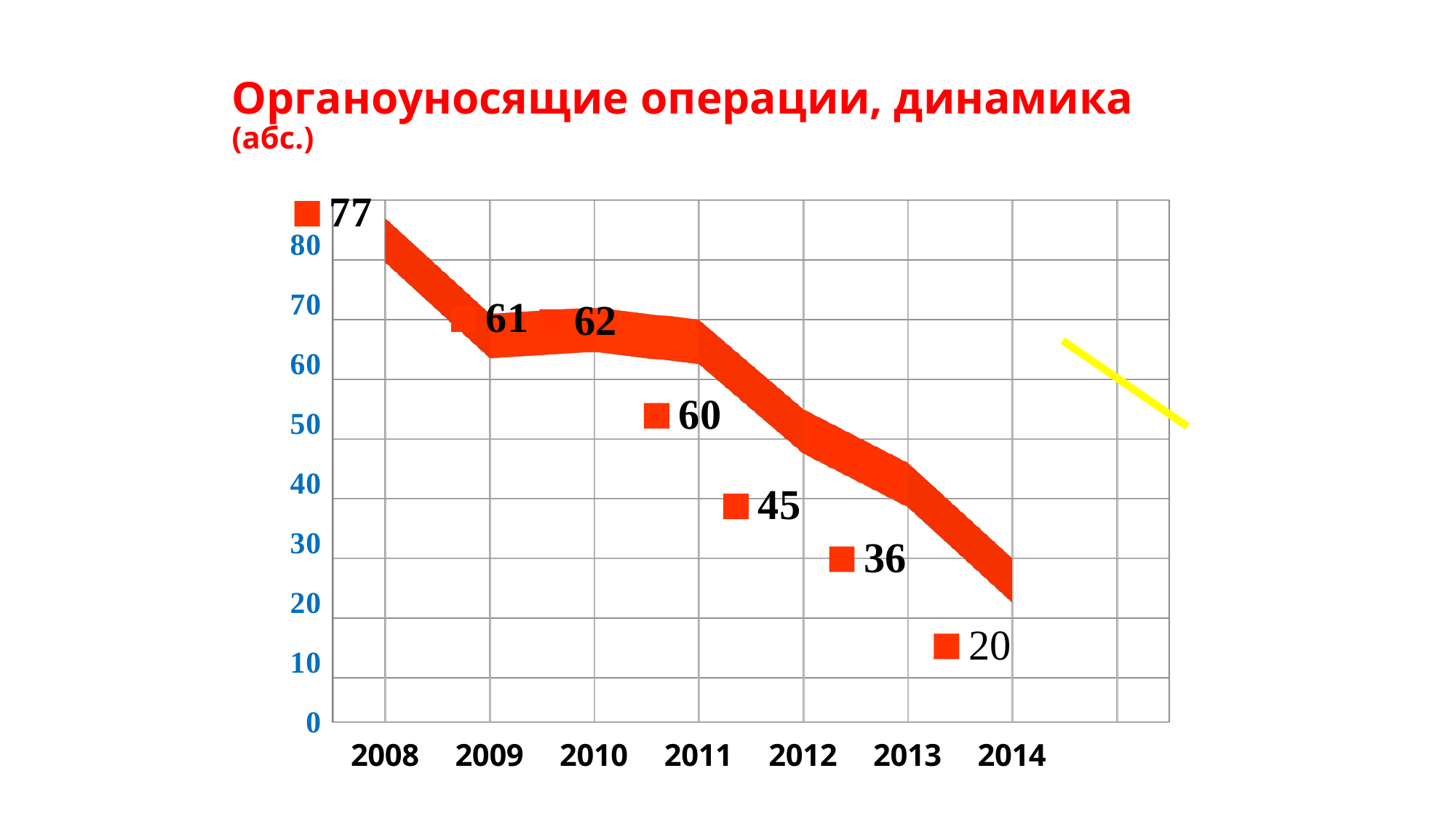
Which year has the lowest value? 2014 What is the difference between the values for 2008 and 2014? 57 Which year has the highest value? 2008 What is the difference between the values for 2012 and 2013? 9 What is the value for 2008? 77 What is the value for 2011? 60 Is the value for 2012 greater or less than 40? greater Which is larger, the value for 2009 or the value for 2010? 2010 What kind of chart is shown on the slide? line chart What is the value for 2014? 20 How many years are shown on the x axis? 7 Do the values generally rise or fall from 2008 to 2014? fall